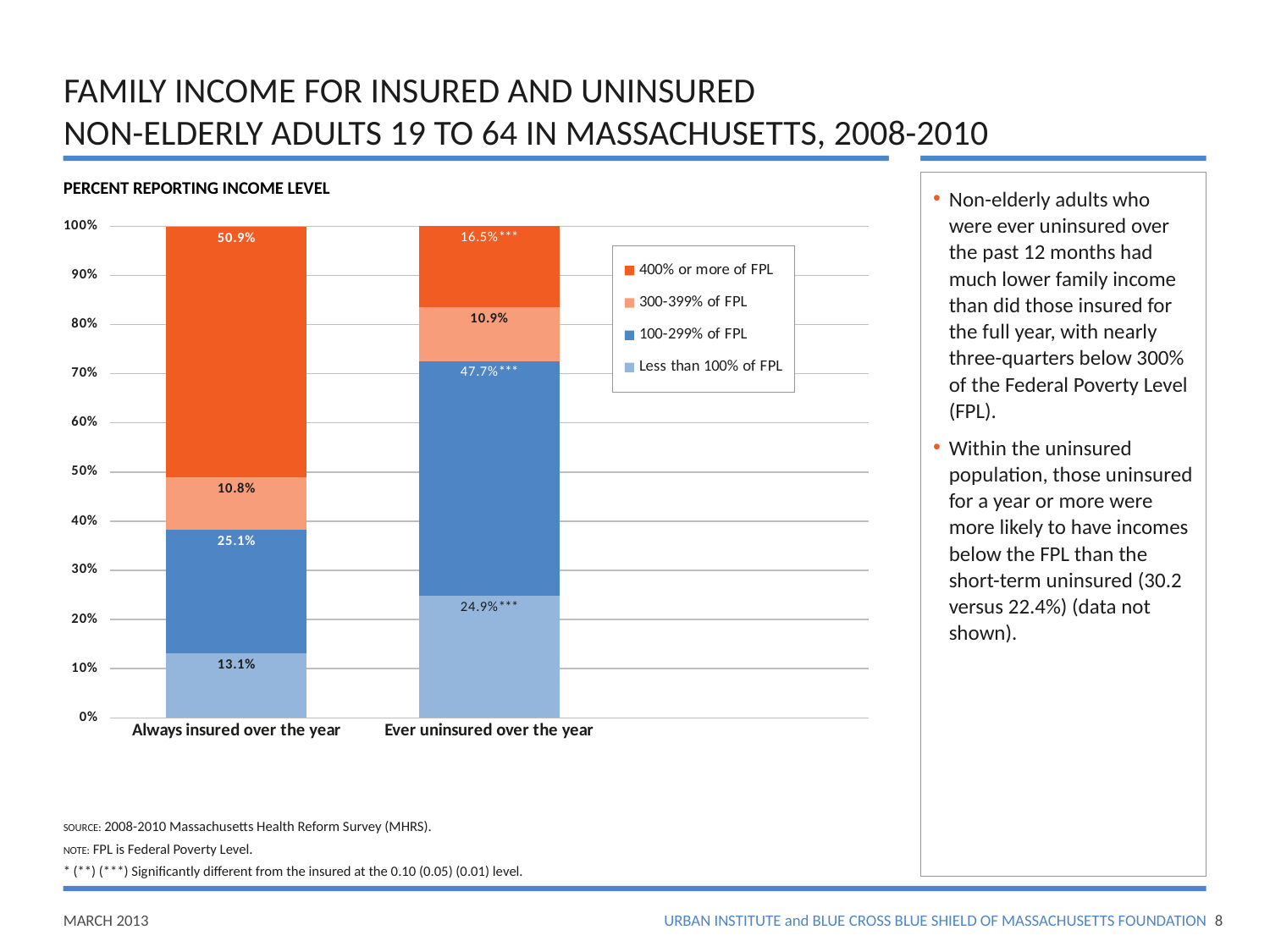
How many percentage points higher is the '400% or more of FPL' share for always insured adults than for ever uninsured adults? 34.4 percentage points Which income level makes up the largest share of the 'Always insured over the year' bar? 400% or more of FPL What percentage of adults ever uninsured over the year reported income of 100-299% of FPL? 47.7% What is the value for '300-399% of FPL' in the 'Always insured over the year' bar? 10.8% What percentage of always insured adults reported income of 400% or more of FPL? 50.9% What is the value for 'Less than 100% of FPL' in the 'Ever uninsured over the year' bar? 24.9% What type of chart is shown on the slide? Stacked bar chart Which group has the larger share at 100-299% of FPL, always insured or ever uninsured? Ever uninsured over the year Which income level makes up the smallest share of the 'Ever uninsured over the year' bar? 300-399% of FPL How many categories are shown on the x axis of the chart? 2 How many series does the chart legend list? 4 What is the difference between the 'Less than 100% of FPL' shares for ever uninsured and always insured adults? 11.8 percentage points